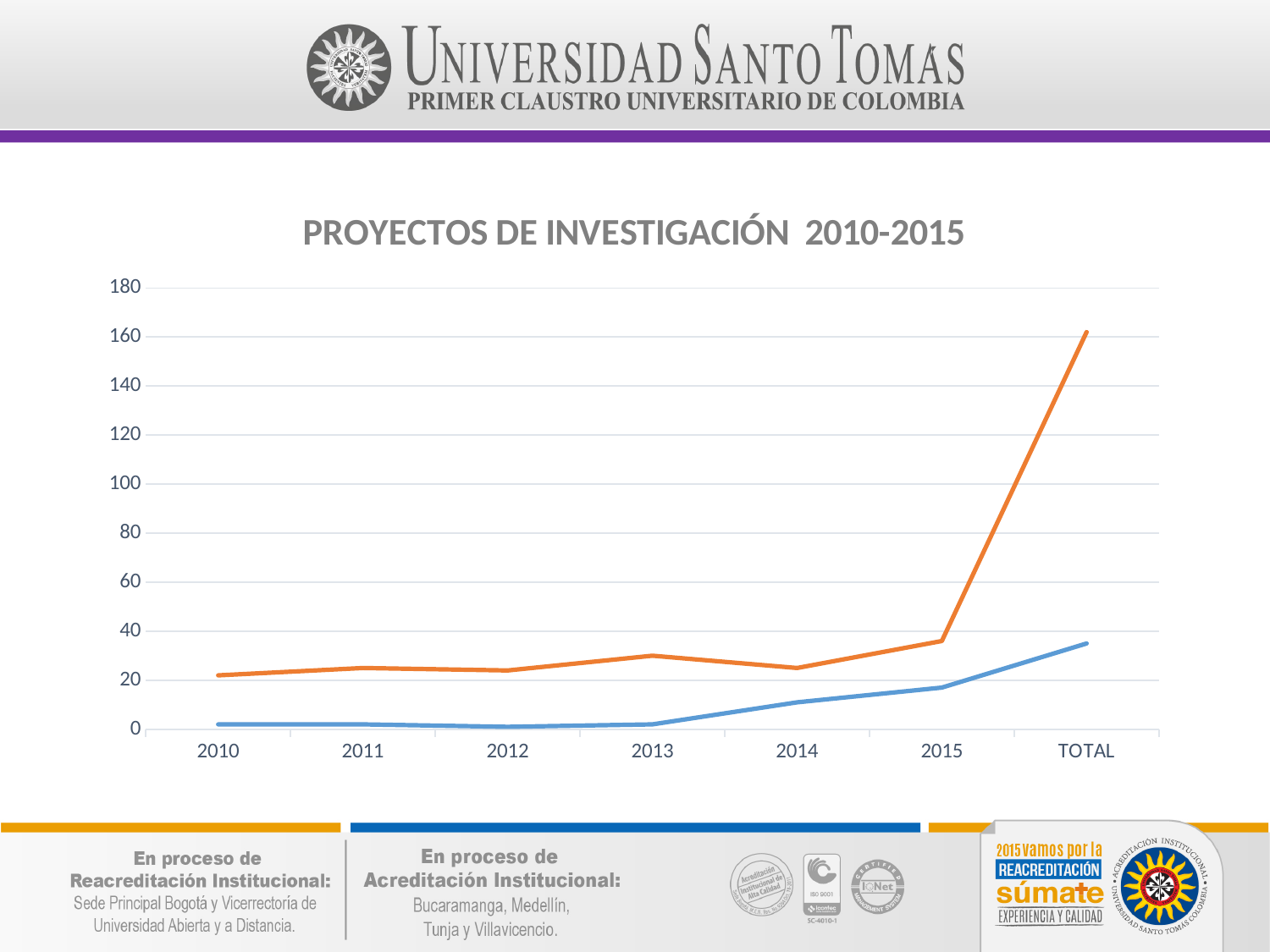
At which x-axis category does the orange line reach its highest value? TOTAL Is the value of the orange line at TOTAL greater or less than 140? greater Does the blue line rise or fall from 2013 to TOTAL? rise At 2014, which line has the larger value, the orange line or the blue line? the orange line Is the value of the blue line at 2013 greater or less than 20? less How many lines are plotted on the chart? 2 What kind of chart is shown on the slide? line chart Is the value of the orange line at 2015 greater or less than 60? less What is the title of the chart? PROYECTOS DE INVESTIGACIÓN 2010-2015 How many categories are shown along the x axis of the chart? 7 At which x-axis category does the blue line reach its highest value? TOTAL